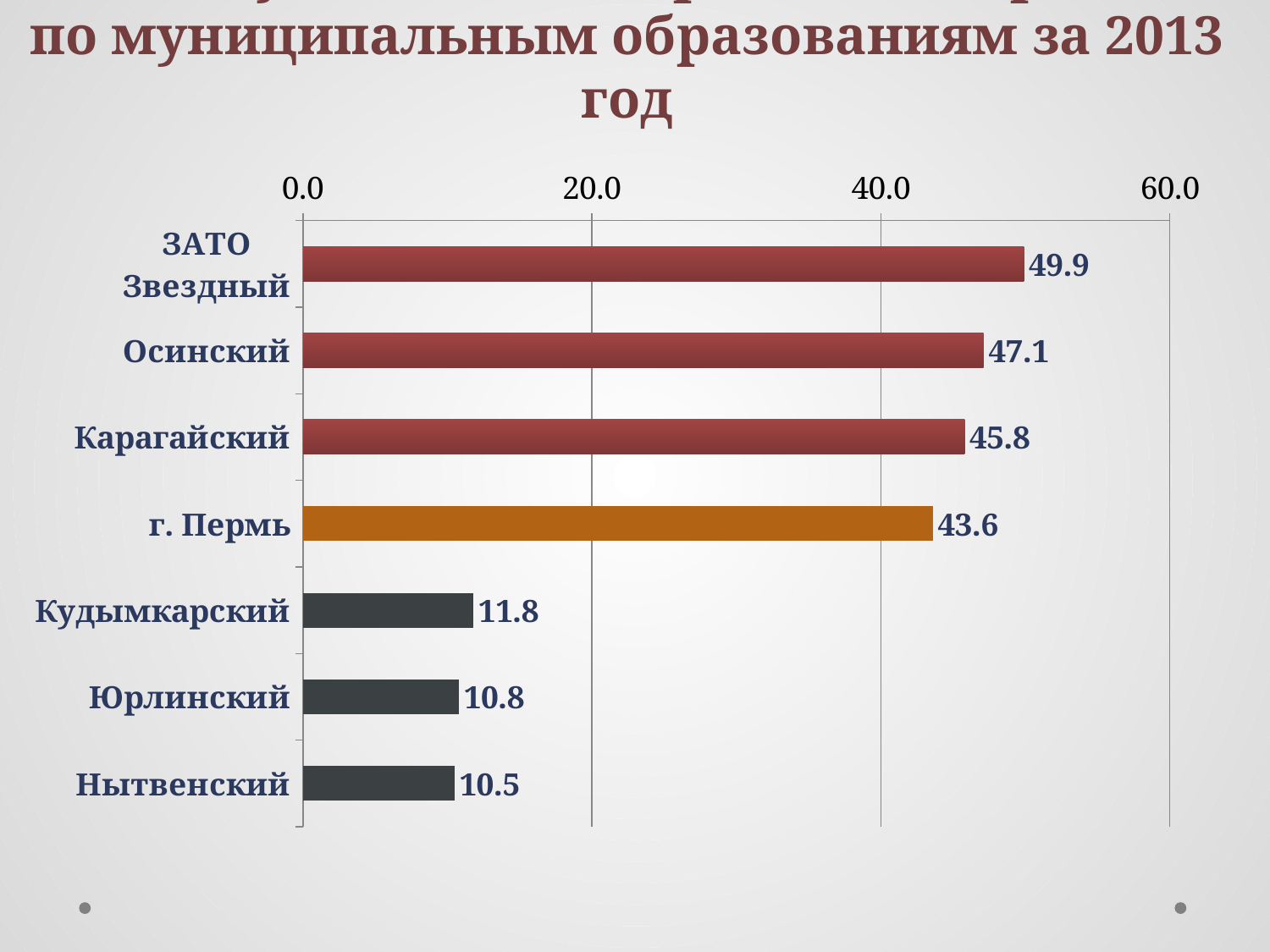
How many categories are shown in the chart? 7 What is the value for Нытвенский? 10.5 Which category has the lowest value? Нытвенский What is the value for ЗАТО Звездный? 49.9 What is the difference between the values for Осинский and Карагайский? 1.3 What is the value for Кудымкарский? 11.8 Which category has the highest value? ЗАТО Звездный What is the difference between the values for ЗАТО Звездный and Нытвенский? 39.4 Is the value for г. Пермь greater or less than 40.0? greater What kind of chart is shown on the slide? bar chart What is the value for г. Пермь? 43.6 Which is larger, the value for Юрлинский or the value for Кудымкарский? Кудымкарский